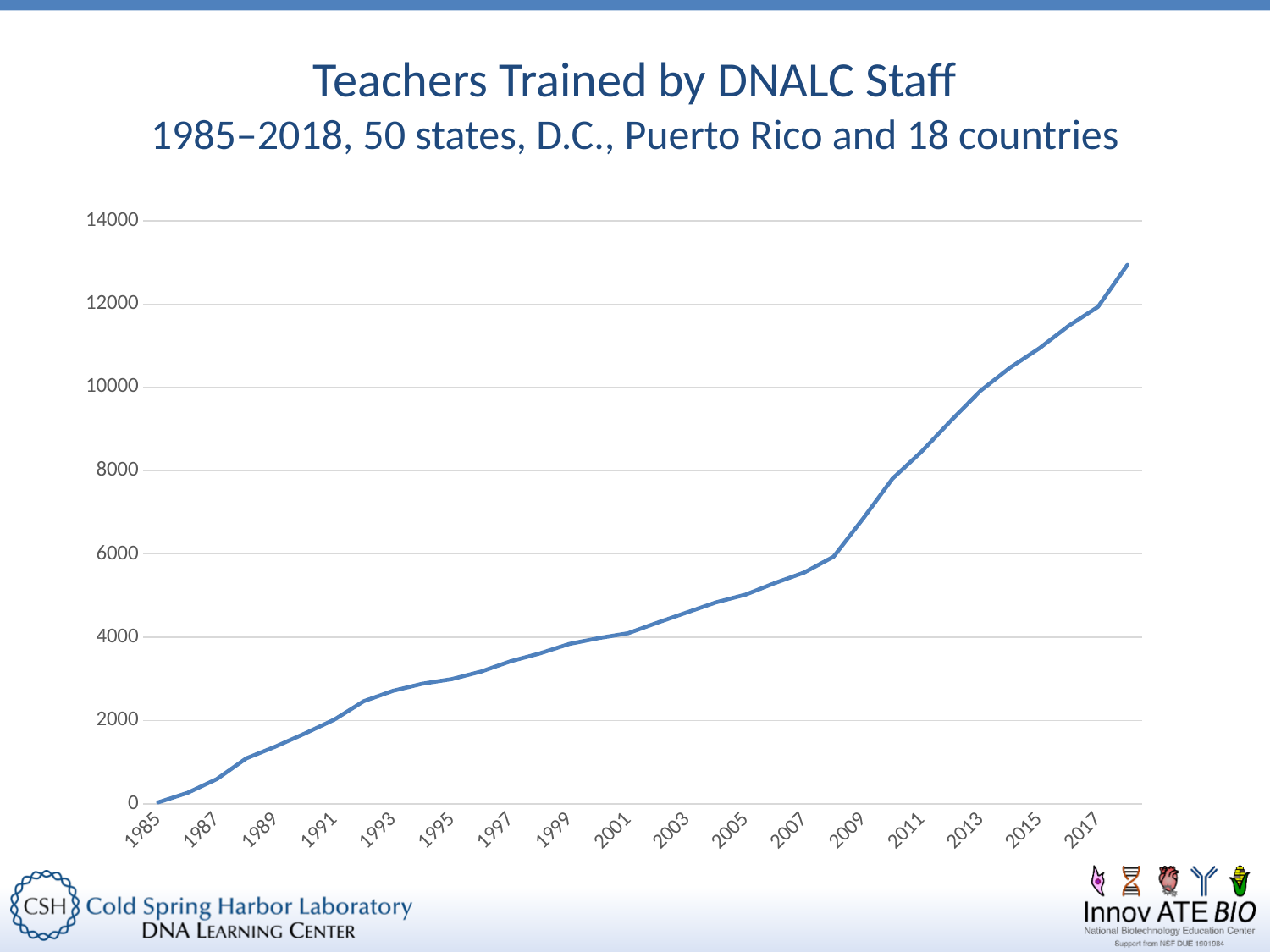
Is the value for 1993 greater or less than 2000? greater Is the value for 2011 greater or less than 8000? greater Is the value for 2009 greater or less than 6000? greater How many year labels are shown on the x axis? 17 What is the title of the chart? Teachers Trained by DNALC Staff Which year has a larger value, 2005 or 2015? 2015 Do the values rise or fall from 1985 to 2017? rise According to the chart subtitle, how many countries are included? 18 countries What kind of chart is shown on the slide? line chart